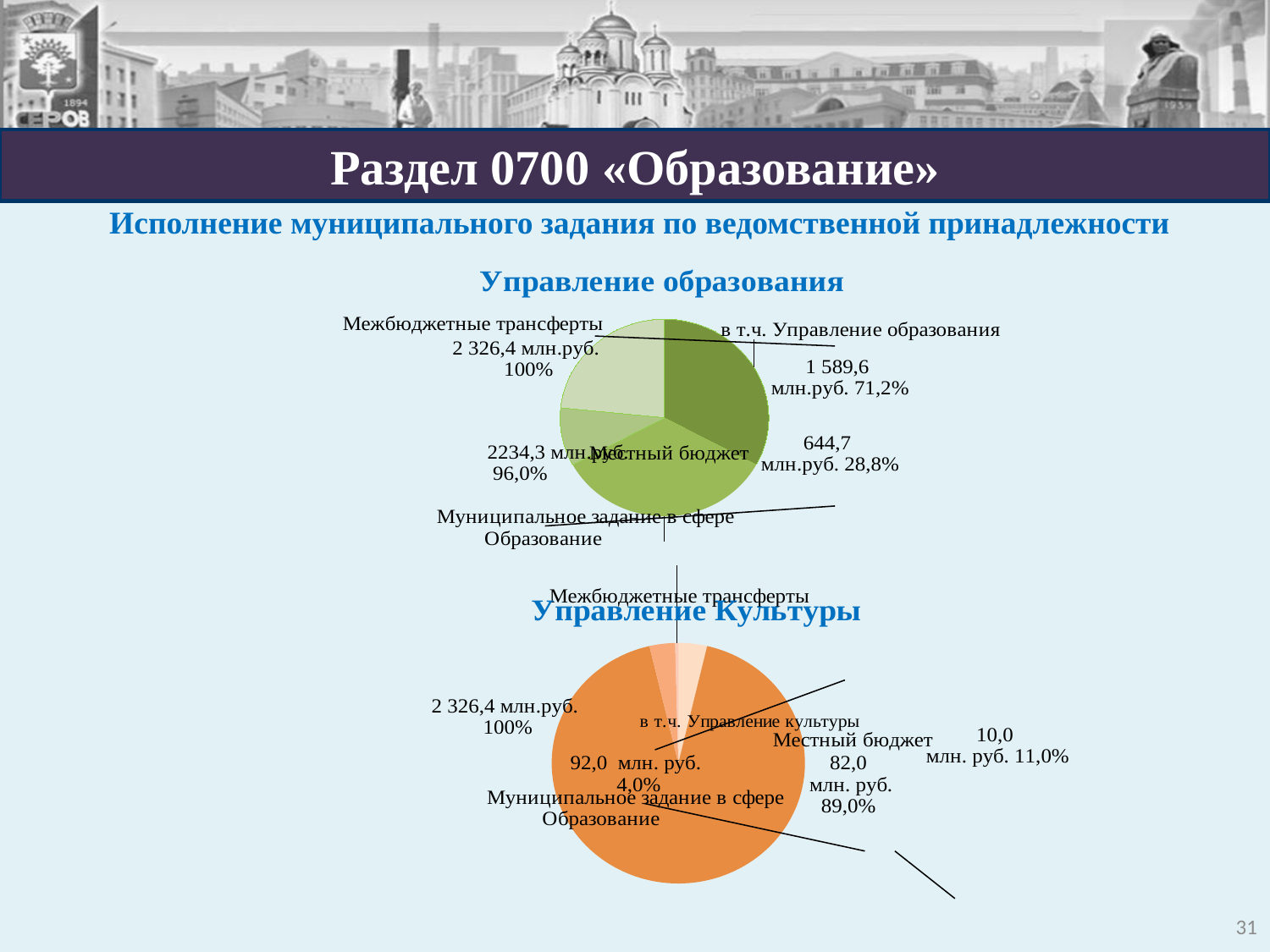
In the «Управление образования» chart, what percentage is shown next to the 644,7 млн.руб. value? 28,8% In the «Управление Культуры» chart, what value is shown for «в т.ч. Управление культуры»? 92,0 млн. руб. 4,0% In the «Управление Культуры» chart, what is the difference between the 89,0% share and the 11,0% share? 78,0% In the «Управление образования» chart, what is the difference between the 1 589,6 млн.руб. value and the 644,7 млн.руб. value? 944,9 млн.руб. What kind of chart is used under the heading «Управление образования»? Pie chart In the «Управление Культуры» chart, what percentage is shown next to the 10,0 млн. руб. value? 11,0% In the «Управление Культуры» chart, what value is shown for «Местный бюджет»? 82,0 млн. руб. 89,0% In the «Управление образования» chart, what value is shown for «в т.ч. Управление образования»? 1 589,6 млн.руб. 71,2% In the «Управление образования» chart, which is larger: the value for «в т.ч. Управление образования» (1 589,6) or the 644,7 млн.руб. value? в т.ч. Управление образования (1 589,6 млн.руб.) In the «Управление образования» chart, what value is shown for «Межбюджетные трансферты»? 2 326,4 млн.руб. 100% How many charts are shown on the slide? 2 What colour are the slices of the «Управление Культуры» pie chart? Orange